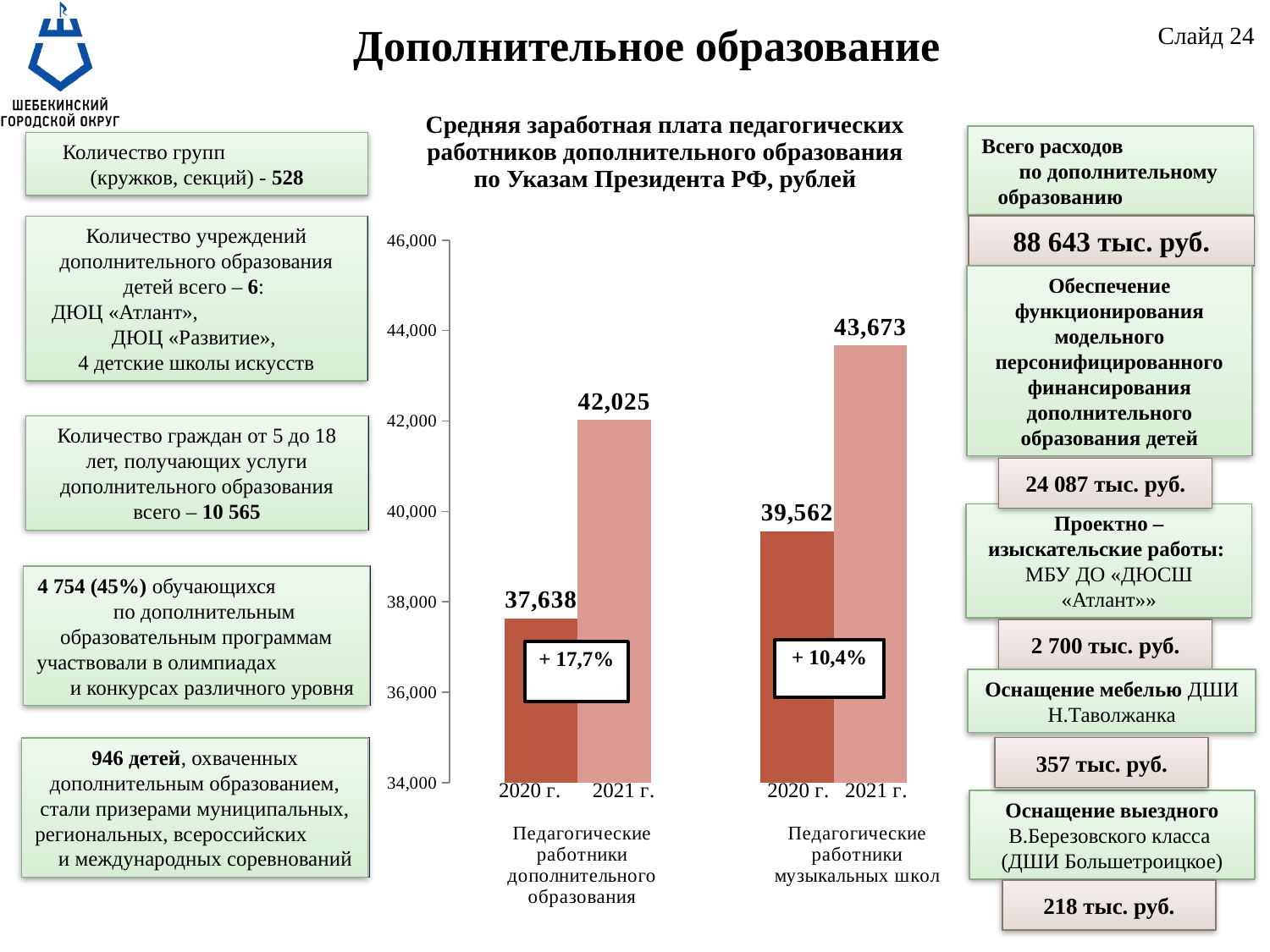
Which bar shows the highest value on the chart? Педагогические работники музыкальных школ, 2021 г. How many bars are plotted on the chart? 4 What percentage growth is shown for teaching staff of additional education? + 17,7% By how much did the average salary of teaching staff of additional education increase from 2020 to 2021? 4,387 What is the average salary of teaching staff of music schools (Педагогические работники музыкальных школ) in 2020? 39,562 By how much did the average salary of teaching staff of music schools increase from 2020 to 2021? 4,111 What is the average salary of teaching staff of additional education (Педагогические работники дополнительного образования) in 2020? 37,638 Which bar shows the lowest value on the chart? Педагогические работники дополнительного образования, 2020 г. Which is larger: the 2021 salary of teaching staff of additional education or the 2020 salary of teaching staff of music schools? 2021 salary of teaching staff of additional education What is the average salary of teaching staff of music schools (Педагогические работники музыкальных школ) in 2021? 43,673 What type of chart is shown on the slide? bar chart What is the average salary of teaching staff of additional education (Педагогические работники дополнительного образования) in 2021? 42,025